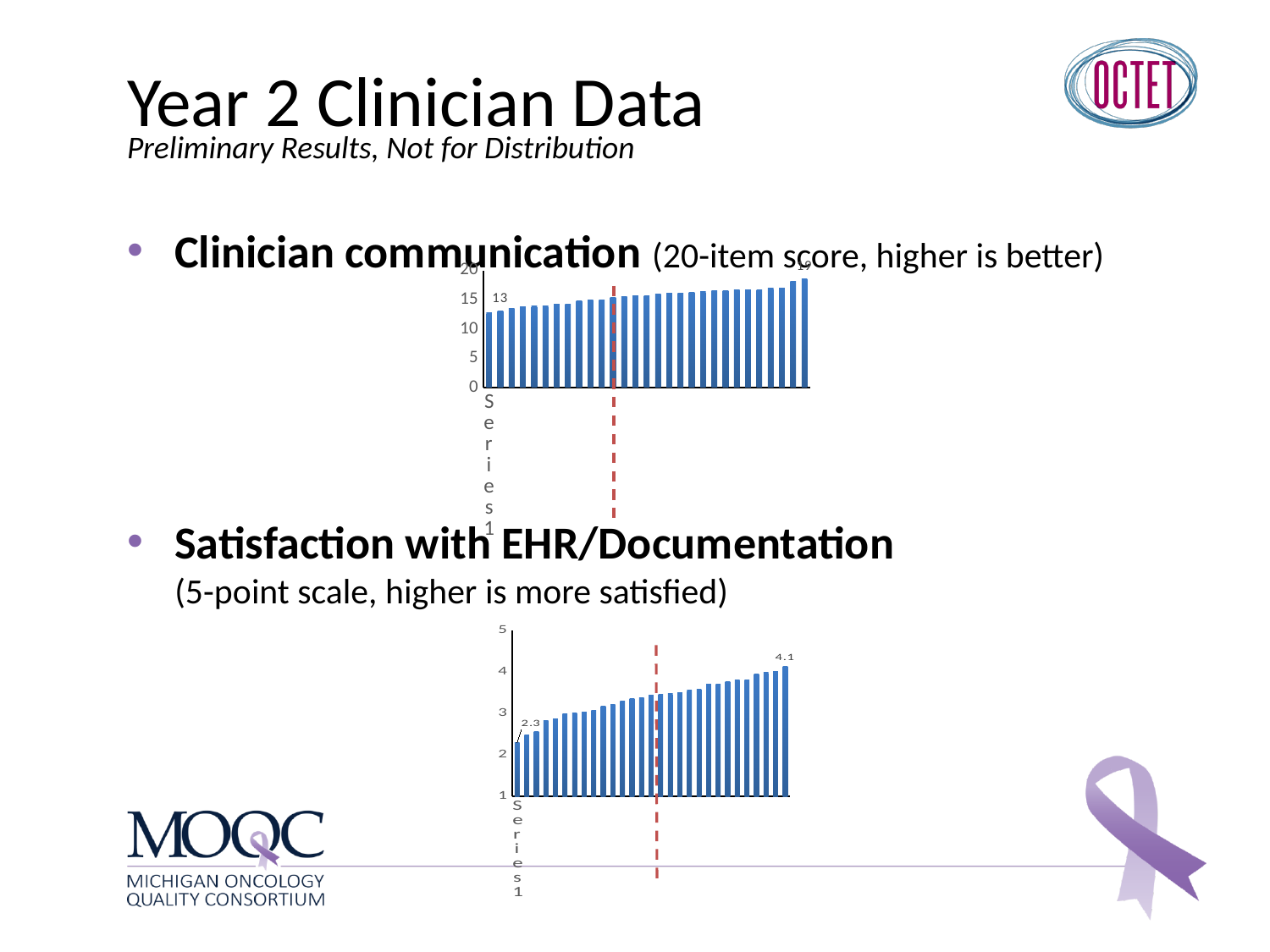
In the Satisfaction with EHR/Documentation chart, what value is labelled on the last (rightmost) bar? 4.1 In the Satisfaction with EHR/Documentation chart, do the bar values rise or fall from left to right? rise In the Satisfaction with EHR/Documentation chart, is the value of the first (leftmost) bar greater or less than 3? less What is the highest value shown on the y-axis of the Clinician communication chart? 20 In the Satisfaction with EHR/Documentation chart, what is the difference between the labelled last bar and the labelled first bar? 1.8 In the Satisfaction with EHR/Documentation chart, which is larger, the first bar or the last bar? the last bar In the Satisfaction with EHR/Documentation chart, what value is labelled on the first (leftmost) bar? 2.3 In the Clinician communication chart, what value is labelled on the first (leftmost) bar? 13 In the Clinician communication chart, is the value of the first (leftmost) bar greater or less than 15? less What kind of chart is the Clinician communication chart at the top of the slide? bar chart In the Clinician communication chart, do the bar values rise or fall from left to right? rise